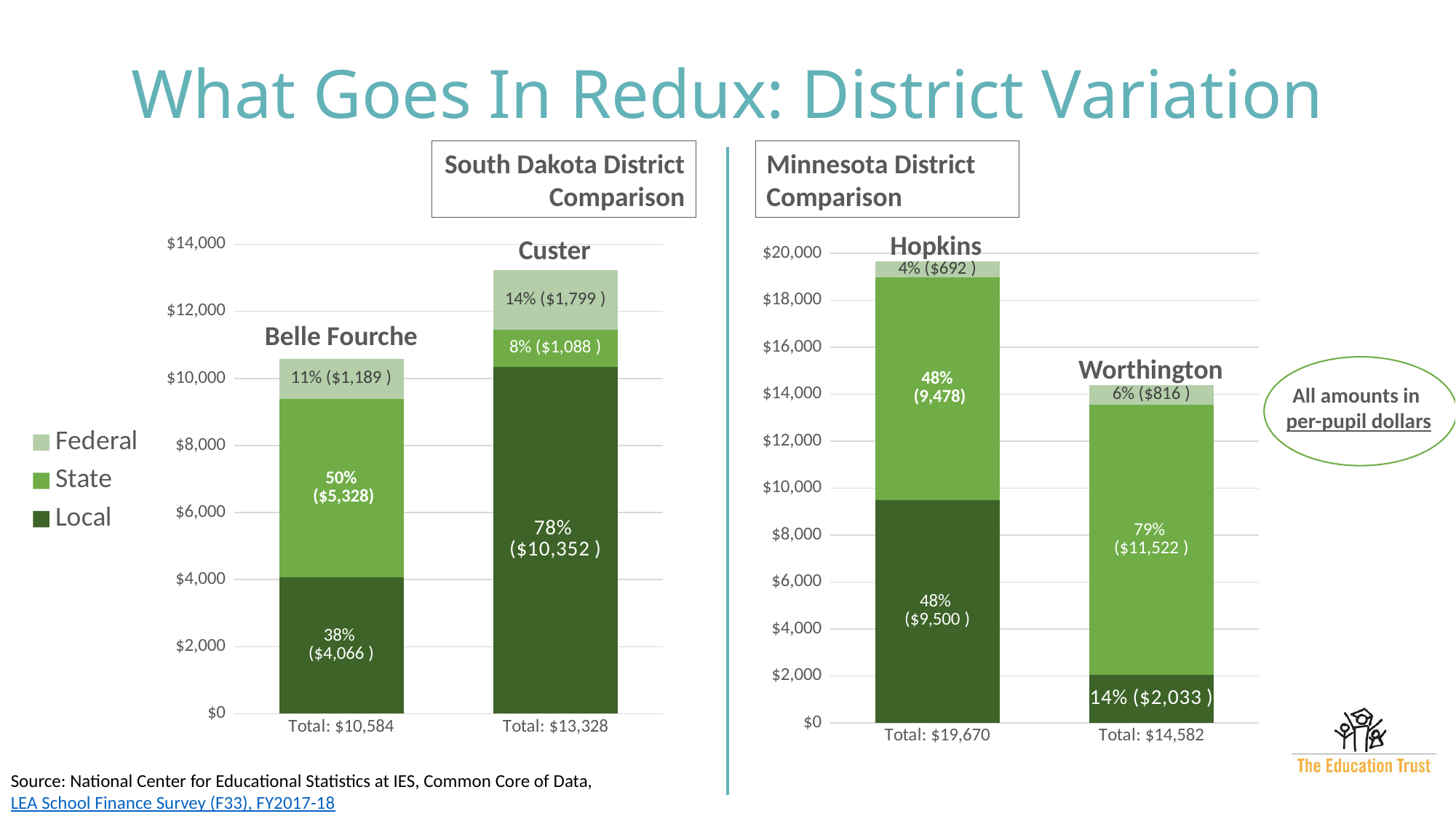
In the Minnesota District Comparison chart, what is the State amount for Worthington? $11,522 In the South Dakota District Comparison chart, what is the total for Custer? $13,328 In the South Dakota District Comparison chart, what is the Local amount for Custer? $10,352 In the South Dakota District Comparison chart, what is the difference between the Federal amounts for Custer and Belle Fourche? $610 How many districts are shown in the South Dakota District Comparison chart? 2 In the Minnesota District Comparison chart, is the total for Worthington greater or less than $16,000? less What type of chart is the Minnesota District Comparison chart? Stacked bar chart In the South Dakota District Comparison chart, what percentage of Belle Fourche's funding comes from the State? 50% How many series does the legend list for the charts? 3 In the Minnesota District Comparison chart, what is the Federal amount for Hopkins? $692 In the Minnesota District Comparison chart, which district has the higher total? Hopkins In the Minnesota District Comparison chart, which is larger: the Local amount for Hopkins or the Local amount for Worthington? Hopkins